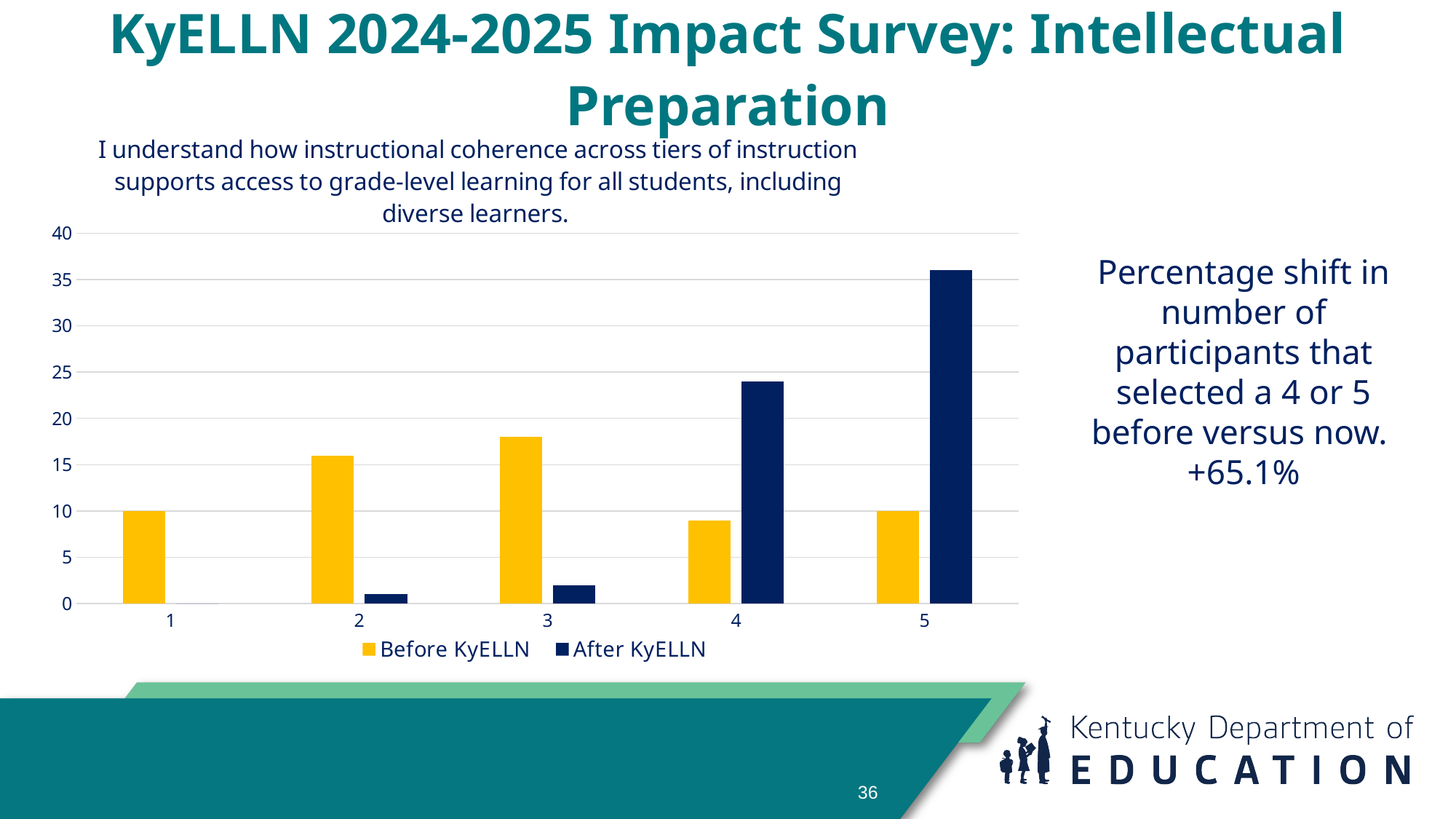
Do the After KyELLN values rise or fall from category 1 to category 5? rise How many categories are shown on the x axis? 5 What kind of chart is shown on the slide? bar chart Which category has the highest Before KyELLN value? 3 Is the After KyELLN value for category 4 greater or less than 20? greater How many series does the legend list? 2 What is the Before KyELLN value for category 1? 10 For category 4, which is larger: the Before KyELLN value or the After KyELLN value? After KyELLN What is the Before KyELLN value for category 5? 10 Is the After KyELLN value for category 5 greater or less than 35? greater Which category has the highest After KyELLN value? 5 Is the After KyELLN value for category 3 greater or less than 5? less